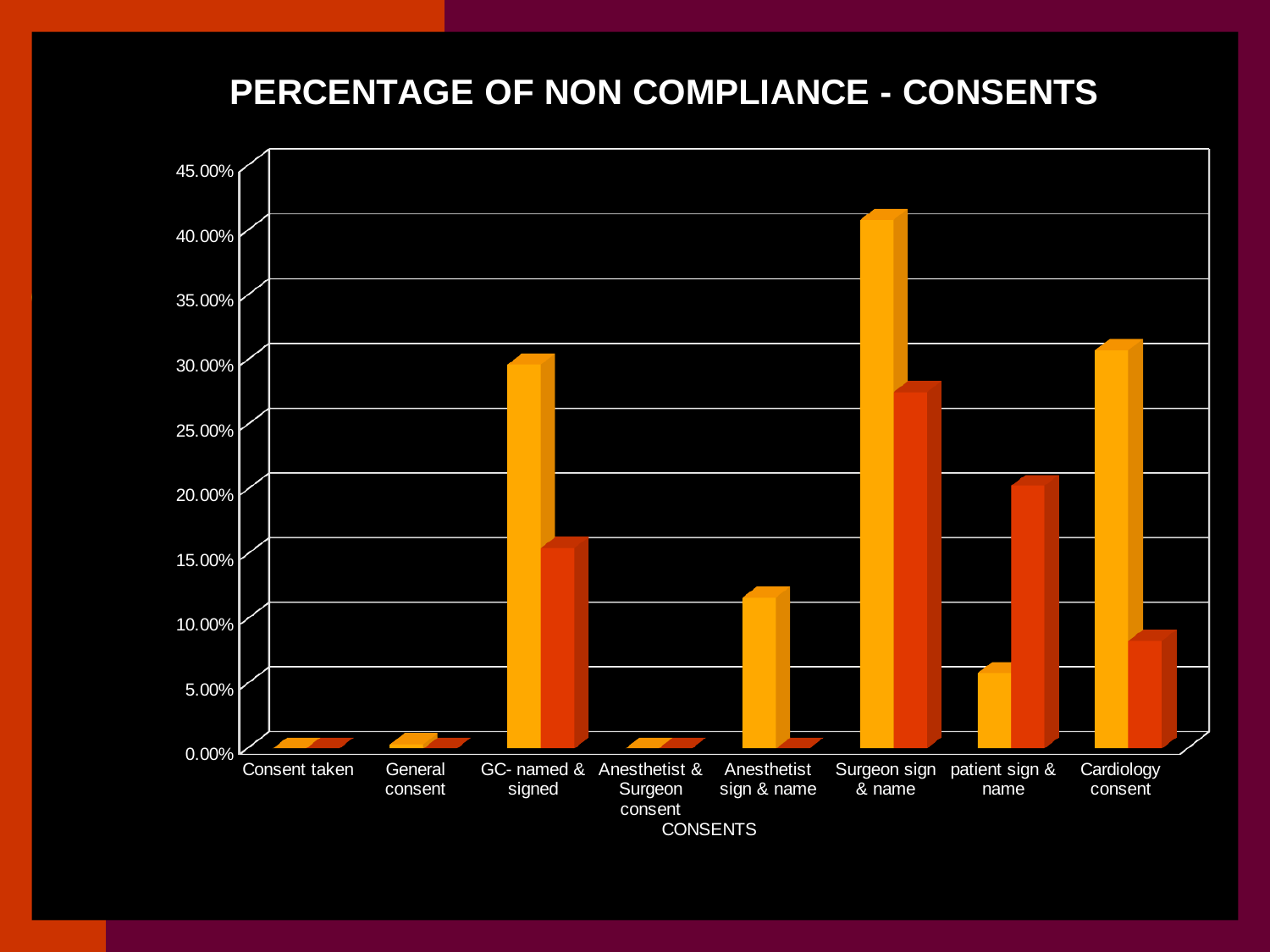
Which is larger, the yellow bar for Surgeon sign & name or the yellow bar for Cardiology consent? Surgeon sign & name For patient sign & name, which bar is taller, the yellow bar or the red bar? the red bar Which category has the tallest yellow bar? Surgeon sign & name What kind of chart is shown on the slide? bar chart Is the yellow bar for Anesthetist sign & name greater or less than 15.00%? less Is the red bar for patient sign & name greater or less than 15.00%? greater How many consent categories are shown on the x axis? 8 What is the title of the chart? PERCENTAGE OF NON COMPLIANCE - CONSENTS Which category has the tallest red bar? Surgeon sign & name Is the yellow bar for GC- named & signed greater or less than 25.00%? greater What is the label of the x axis? CONSENTS